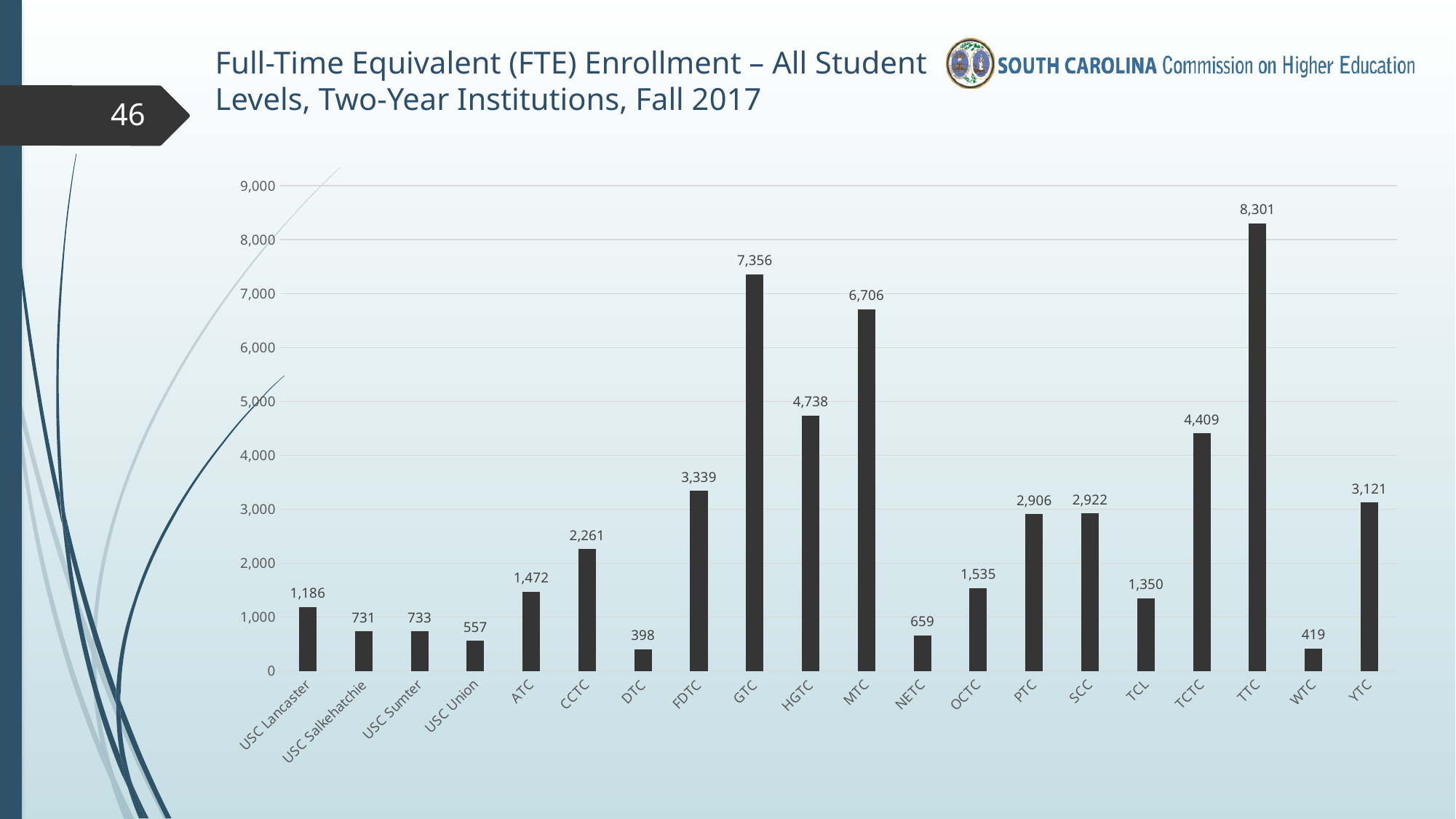
Which institution has the lowest FTE enrollment? DTC Which institution has the highest FTE enrollment? TTC Which has a higher FTE enrollment, FDTC or YTC? FDTC What is the difference in FTE enrollment between TTC and GTC? 945 What is the difference in FTE enrollment between MTC and HGTC? 1,968 What kind of chart is shown on the slide? bar chart What is the FTE enrollment for GTC? 7,356 What is the FTE enrollment for USC Union? 557 How many institutions are shown on the chart? 20 What is the title of the chart on the slide? Full-Time Equivalent (FTE) Enrollment – All Student Levels, Two-Year Institutions, Fall 2017 Is the FTE enrollment for OCTC greater or less than 2,000? less What is the FTE enrollment for TCTC? 4,409